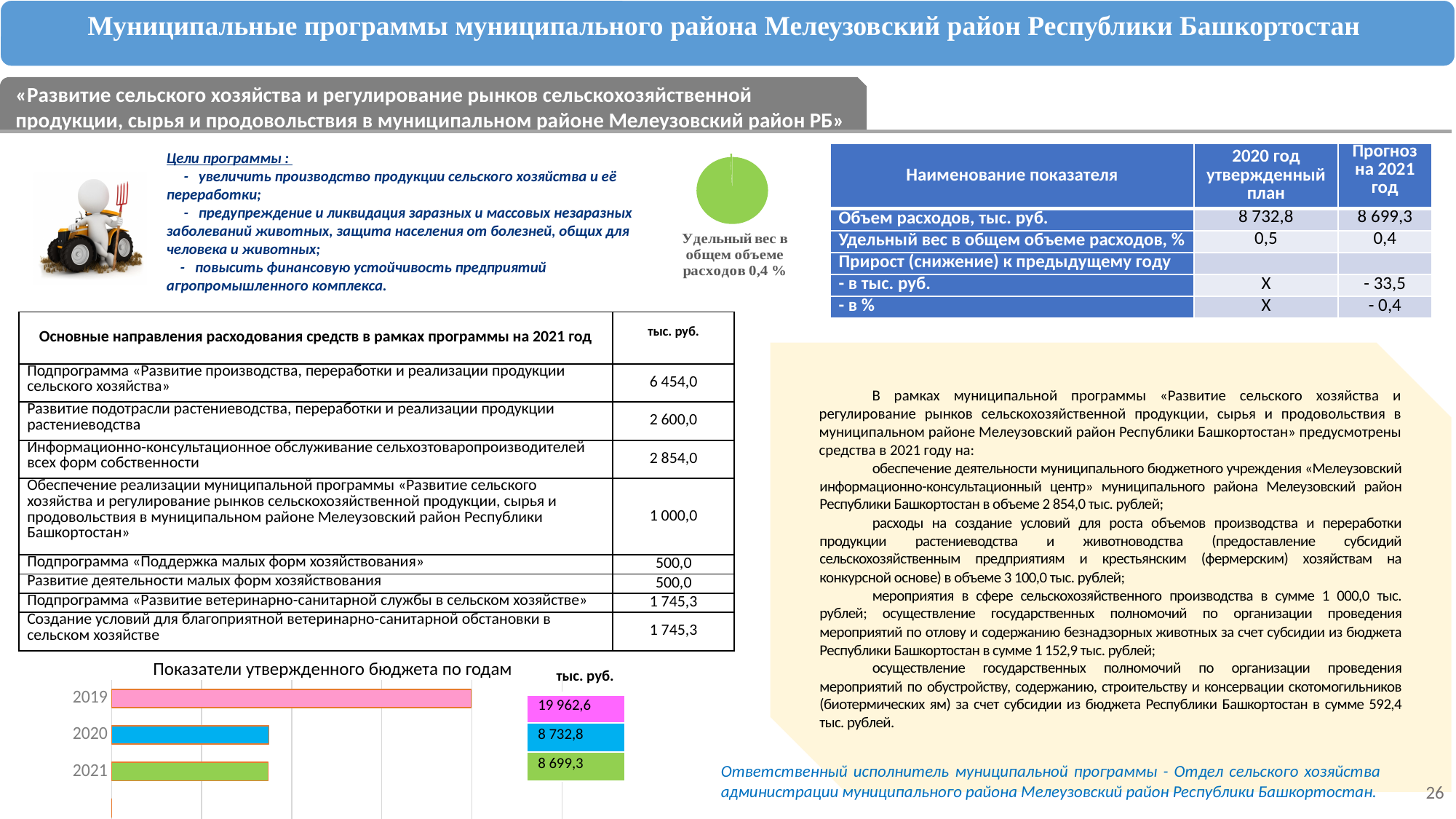
In the bar chart 'Показатели утвержденного бюджета по годам', which year has the highest value? 2019 In the bar chart 'Показатели утвержденного бюджета по годам', which is larger, the value for 2019 or the value for 2021? 2019 In the bar chart 'Показатели утвержденного бюджета по годам', what is the value for 2020? 8 732,8 In the bar chart 'Показатели утвержденного бюджета по годам', what is the difference between the values for 2020 and 2021? 33,5 How many years are shown in the bar chart 'Показатели утвержденного бюджета по годам'? 3 In the bar chart 'Показатели утвержденного бюджета по годам', what is the value for 2019? 19 962,6 In the bar chart 'Показатели утвержденного бюджета по годам', do the values rise or fall from 2019 to 2021? fall In the bar chart 'Показатели утвержденного бюджета по годам', what is the value for 2021? 8 699,3 What unit is indicated for the values in the bar chart 'Показатели утвержденного бюджета по годам'? тыс. руб. In the bar chart 'Показатели утвержденного бюджета по годам', which year has the lowest value? 2021 What kind of chart is 'Показатели утвержденного бюджета по годам'? bar chart In the bar chart 'Показатели утвержденного бюджета по годам', what is the difference between the values for 2019 and 2020? 11 229,8